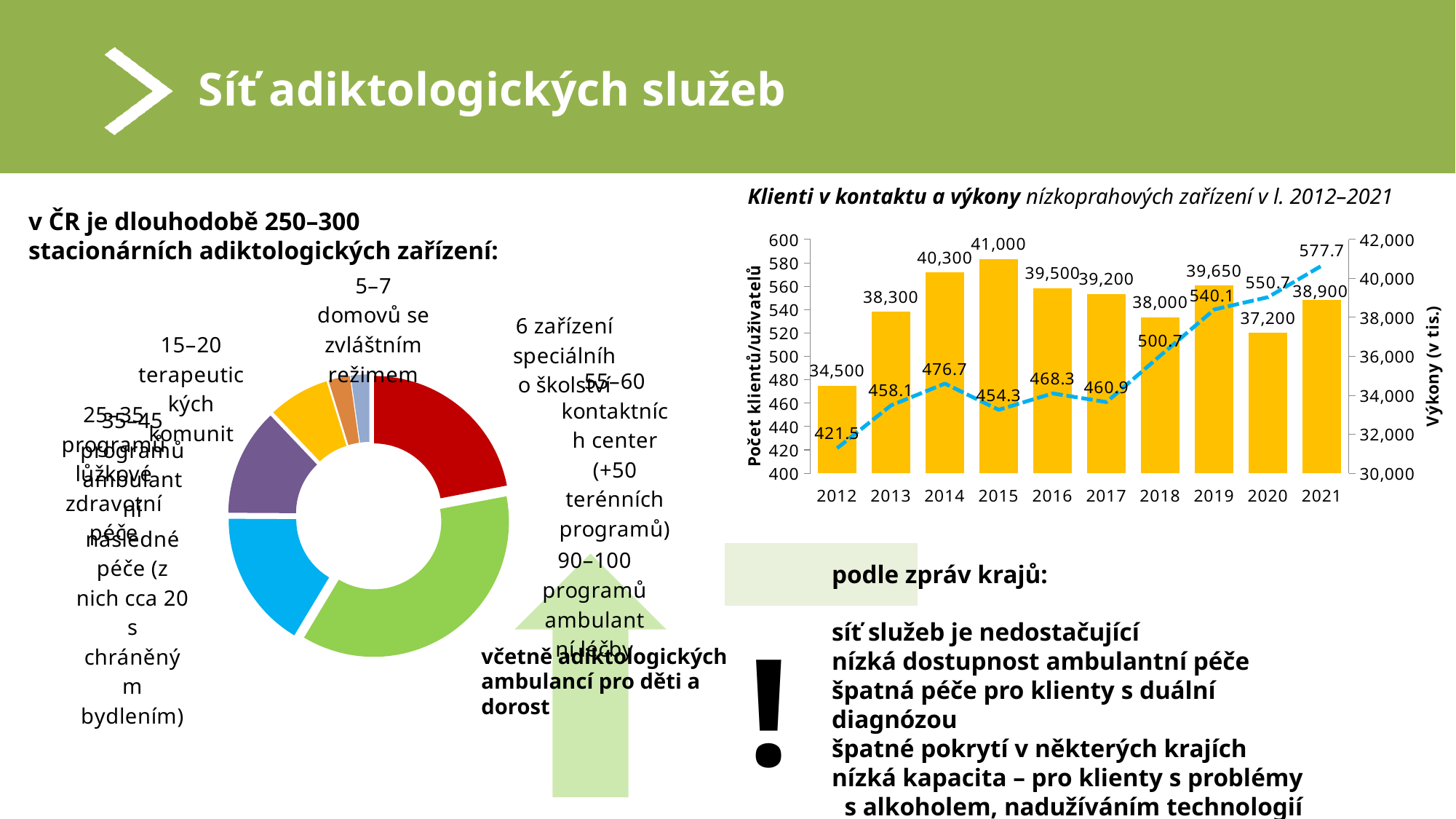
In the chart 'Klienti v kontaktu a výkony nízkoprahových zařízení v l. 2012–2021', which year has the lowest bar? 2012 In the chart 'Klienti v kontaktu a výkony nízkoprahových zařízení v l. 2012–2021', what is the value of the bar for 2012? 34,500 What kind of chart is the chart on the left side of the slide? donut chart In the chart 'Klienti v kontaktu a výkony nízkoprahových zařízení v l. 2012–2021', what is the value of the dashed line for 2021? 577.7 In the chart 'Klienti v kontaktu a výkony nízkoprahových zařízení v l. 2012–2021', what is the difference between the bar values for 2015 and 2012? 6,500 In the chart 'Klienti v kontaktu a výkony nízkoprahových zařízení v l. 2012–2021', which year has the highest bar? 2015 In the chart 'Klienti v kontaktu a výkony nízkoprahových zařízení v l. 2012–2021', how many years are shown on the x axis? 10 In the chart 'Klienti v kontaktu a výkony nízkoprahových zařízení v l. 2012–2021', what is the value of the dashed line for 2012? 421.5 In the chart 'Klienti v kontaktu a výkony nízkoprahových zařízení v l. 2012–2021', does the dashed line rise or fall from 2018 to 2021? rise How many slices does the donut chart on the left side of the slide have? 7 In the chart 'Klienti v kontaktu a výkony nízkoprahových zařízení v l. 2012–2021', what is the value of the bar for 2015? 41,000 In the chart 'Klienti v kontaktu a výkony nízkoprahových zařízení v l. 2012–2021', which year has the larger bar value, 2019 or 2020? 2019